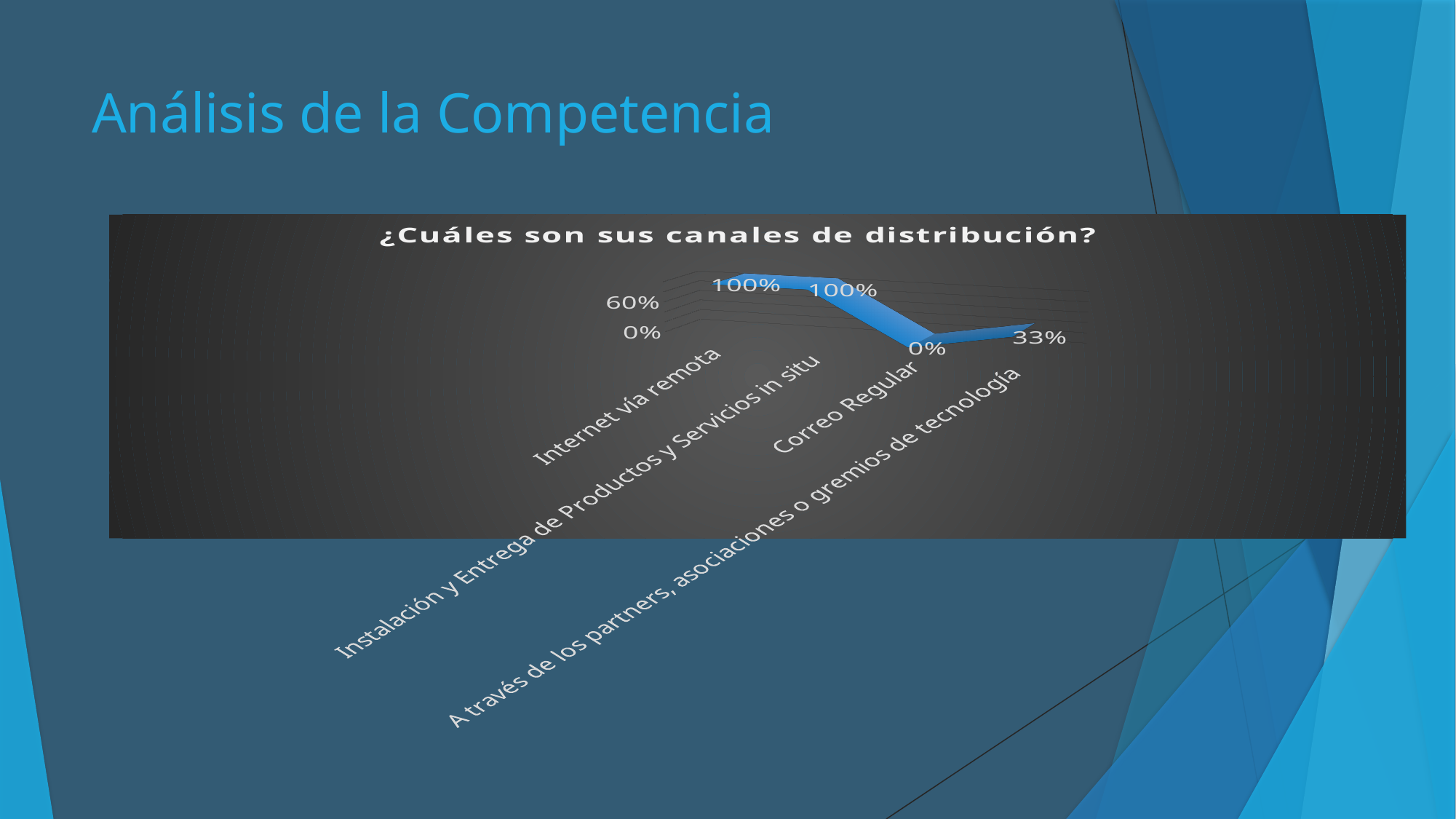
What is the difference between the value for Internet vía remota and the value for A través de los partners, asociaciones o gremios de tecnología? 67% What is the title of the chart? ¿Cuáles son sus canales de distribución? Does the value rise or fall from Instalación y Entrega de Productos y Servicios in situ to Correo Regular? fall What is the value for Correo Regular? 0% How many categories are plotted on the chart? 4 Which is larger, the value for Correo Regular or the value for A través de los partners, asociaciones o gremios de tecnología? A través de los partners, asociaciones o gremios de tecnología What kind of chart is shown on the slide? line chart What is the value for Internet vía remota? 100% What is the value for Instalación y Entrega de Productos y Servicios in situ? 100% Is the value for A través de los partners, asociaciones o gremios de tecnología greater or less than 60%? less What is the value for A través de los partners, asociaciones o gremios de tecnología? 33% Which category has the lowest value? Correo Regular